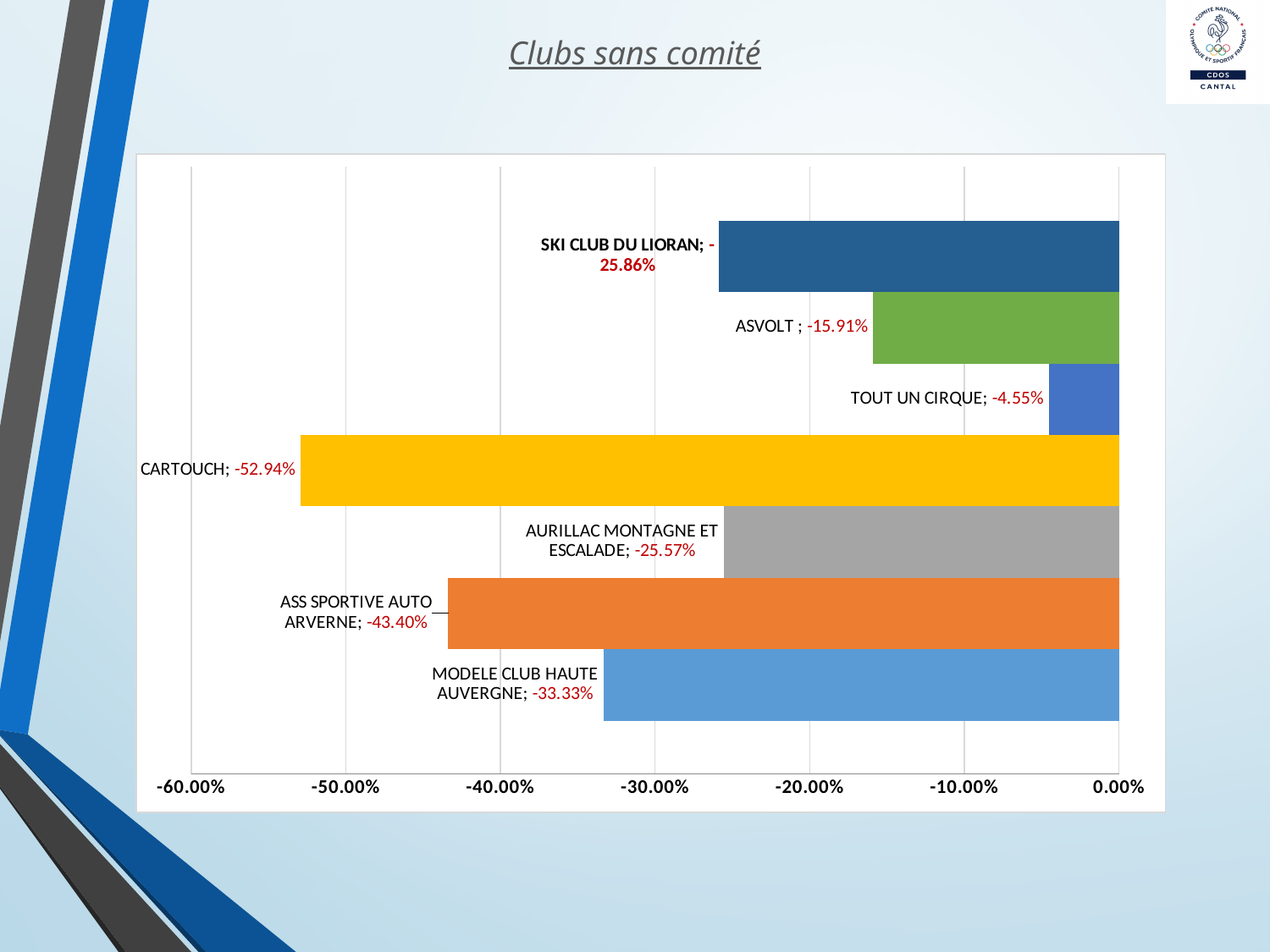
Which club has the highest (least negative) value? TOUT UN CIRQUE What kind of chart is shown on the slide? Bar chart What is the value for ASVOLT? -15.91% What is the value for CARTOUCH? -52.94% How many clubs are shown in the chart? 7 Is the value for CARTOUCH greater or less than -50.00%? less Which has the larger (less negative) value, ASVOLT or SKI CLUB DU LIORAN? ASVOLT What is the difference between the values for ASS SPORTIVE AUTO ARVERNE and MODELE CLUB HAUTE AUVERGNE? 10.07 percentage points What is the difference between the values for CARTOUCH and TOUT UN CIRQUE? 48.39 percentage points Which club has the lowest (most negative) value? CARTOUCH What is the value for MODELE CLUB HAUTE AUVERGNE? -33.33% What is the value for AURILLAC MONTAGNE ET ESCALADE? -25.57%